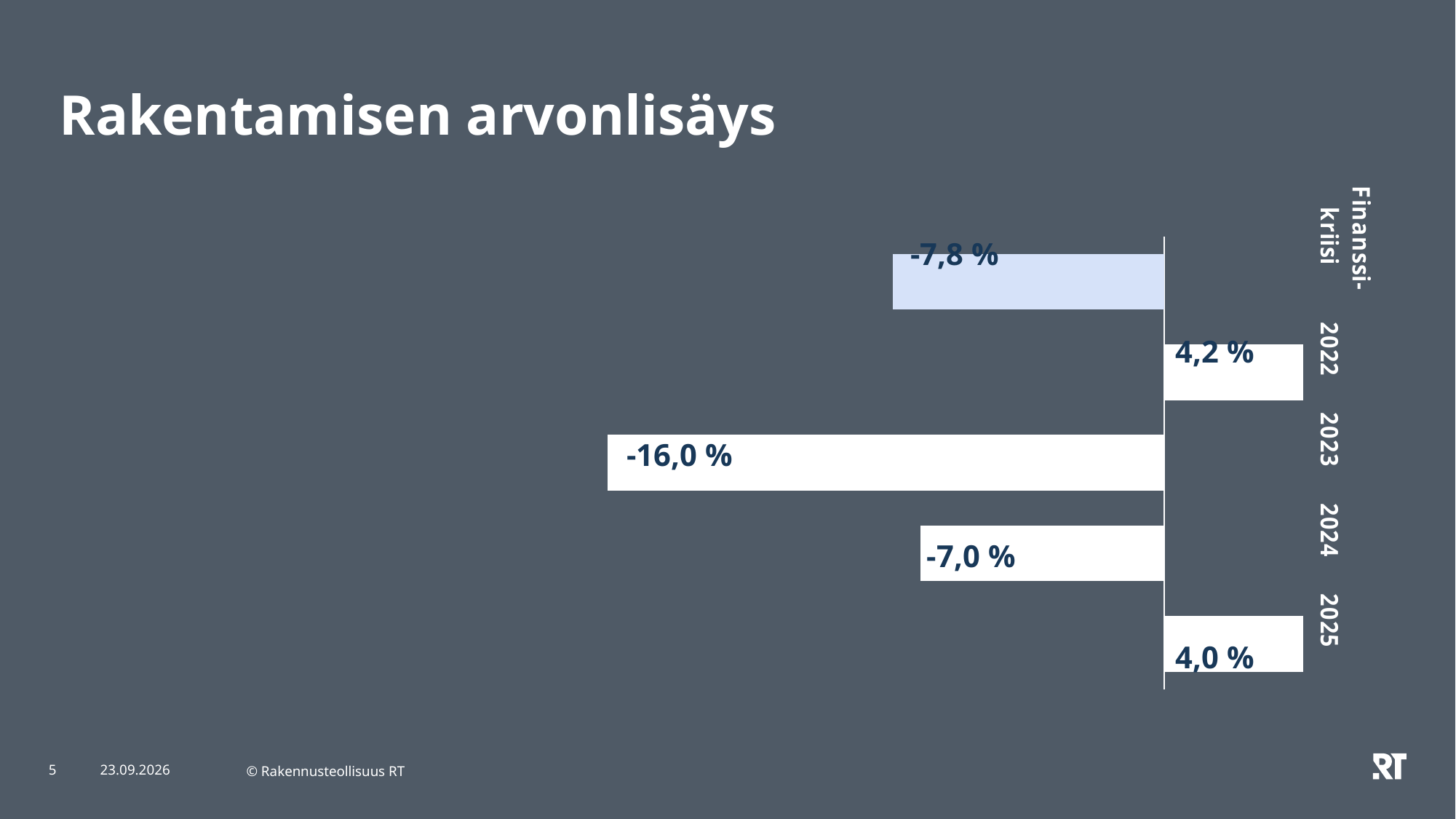
What is the value for the Finanssikriisi category? -7,8 % Which category has the highest value? 2022 What is the difference between the values for 2022 and 2025? 0,2 % Which is larger, the value for 2024 or the value for Finanssikriisi? 2024 How many categories have a negative value? 3 How many categories are shown in the chart? 5 Which category has the lowest value? 2023 What is the title of the slide? Rakentamisen arvonlisäys What is the value for 2025? 4,0 % What is the value for 2023? -16,0 % What kind of chart is shown on the slide? Bar chart What is the value for 2022? 4,2 %